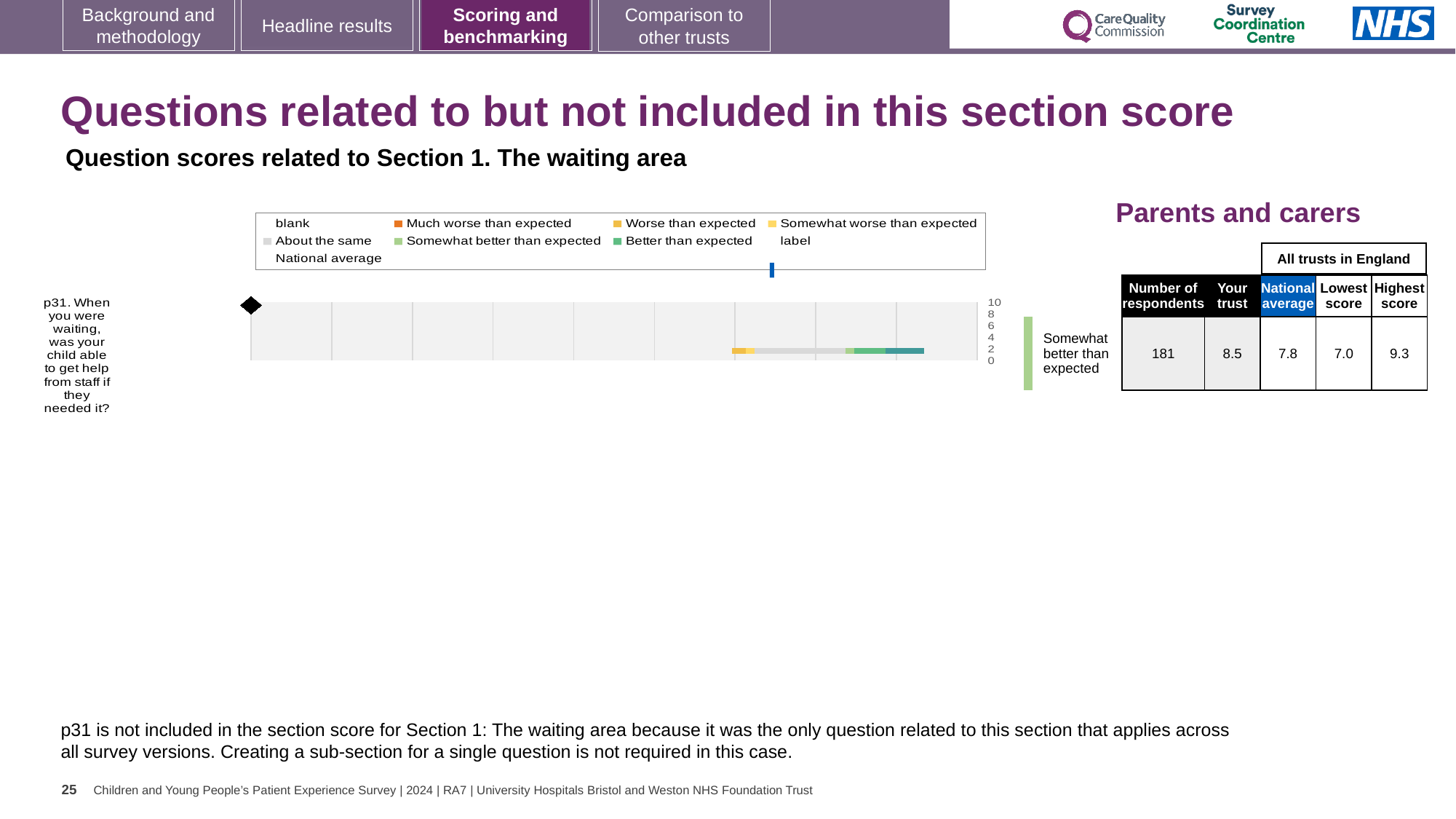
What is the difference between the 'Your trust' score and the national average for p31? 0.7 What kind of chart is used to show the p31 question score? bar chart Is the 'Your trust' score for p31 higher or lower than the national average? higher How many respondents answered p31? 181 What is the highest score among all trusts in England for p31? 9.3 How many questions are plotted in the chart? 1 What is the lowest score among all trusts in England for p31? 7.0 What is the 'Your trust' score for p31? 8.5 What is the national average score for p31? 7.8 What benchmark category is shown for p31 next to the chart? Somewhat better than expected Which question is plotted in the chart? p31. When you were waiting, was your child able to get help from staff if they needed it? What is the difference between the highest and lowest scores for p31 across all trusts in England? 2.3